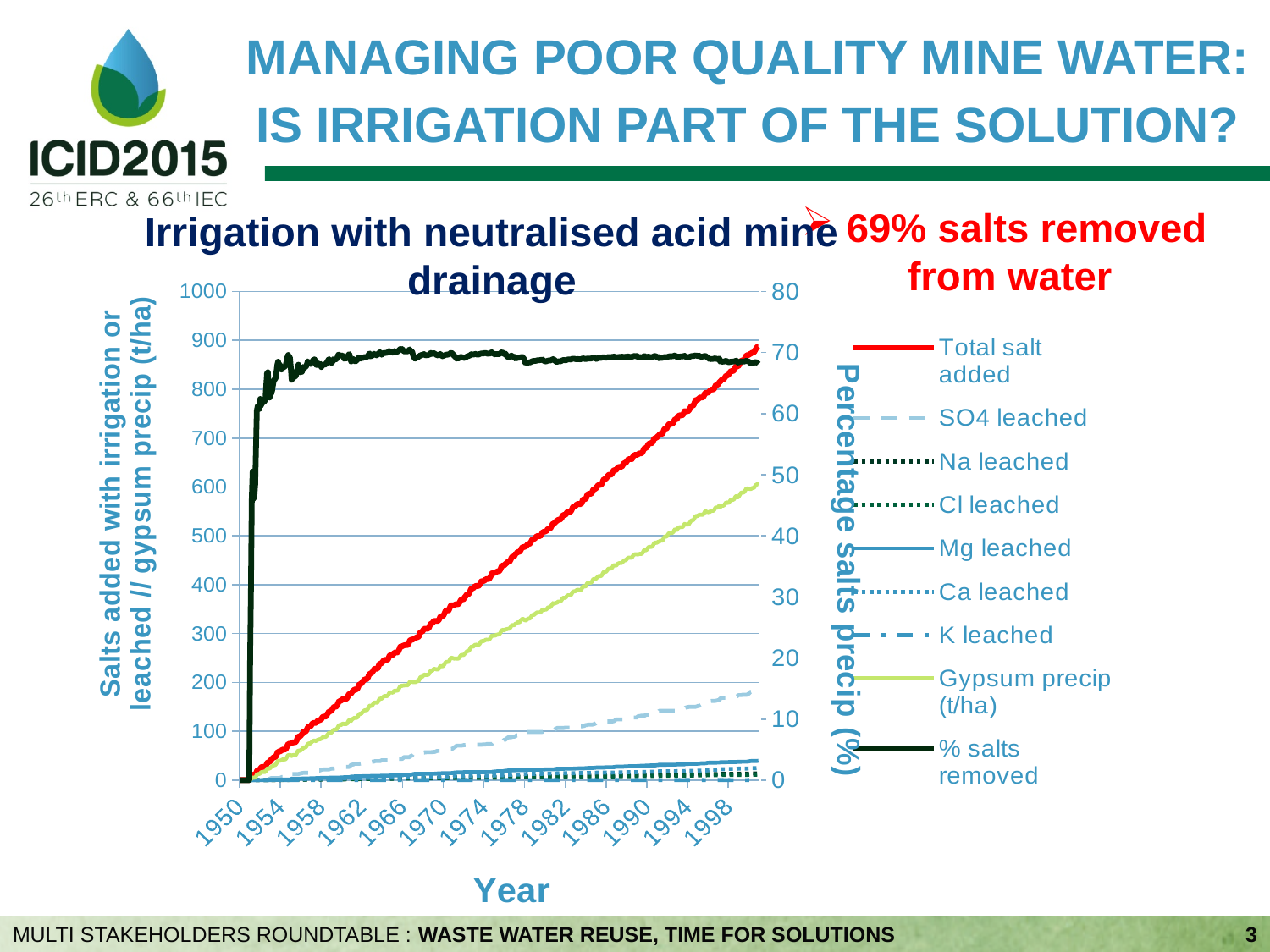
Is the value of % salts removed in 1990 greater or less than 60 on the right axis? greater Does the Total salt added series rise or fall from 1950 to 1998? rise How many series does the chart legend list? 9 Which series reaches the highest value on the left axis by 1998? Total salt added Is the value of SO4 leached in 1998 greater or less than 300 on the left axis? less Is the value of Total salt added in 1998 greater or less than 800 on the left axis? greater What is the label of the x axis of the chart? Year What is the title of the chart? Irrigation with neutralised acid mine drainage How many year tick labels are shown along the x axis? 13 In 1998, which is larger: Total salt added or Gypsum precip (t/ha)? Total salt added What kind of chart is shown on the slide? line chart